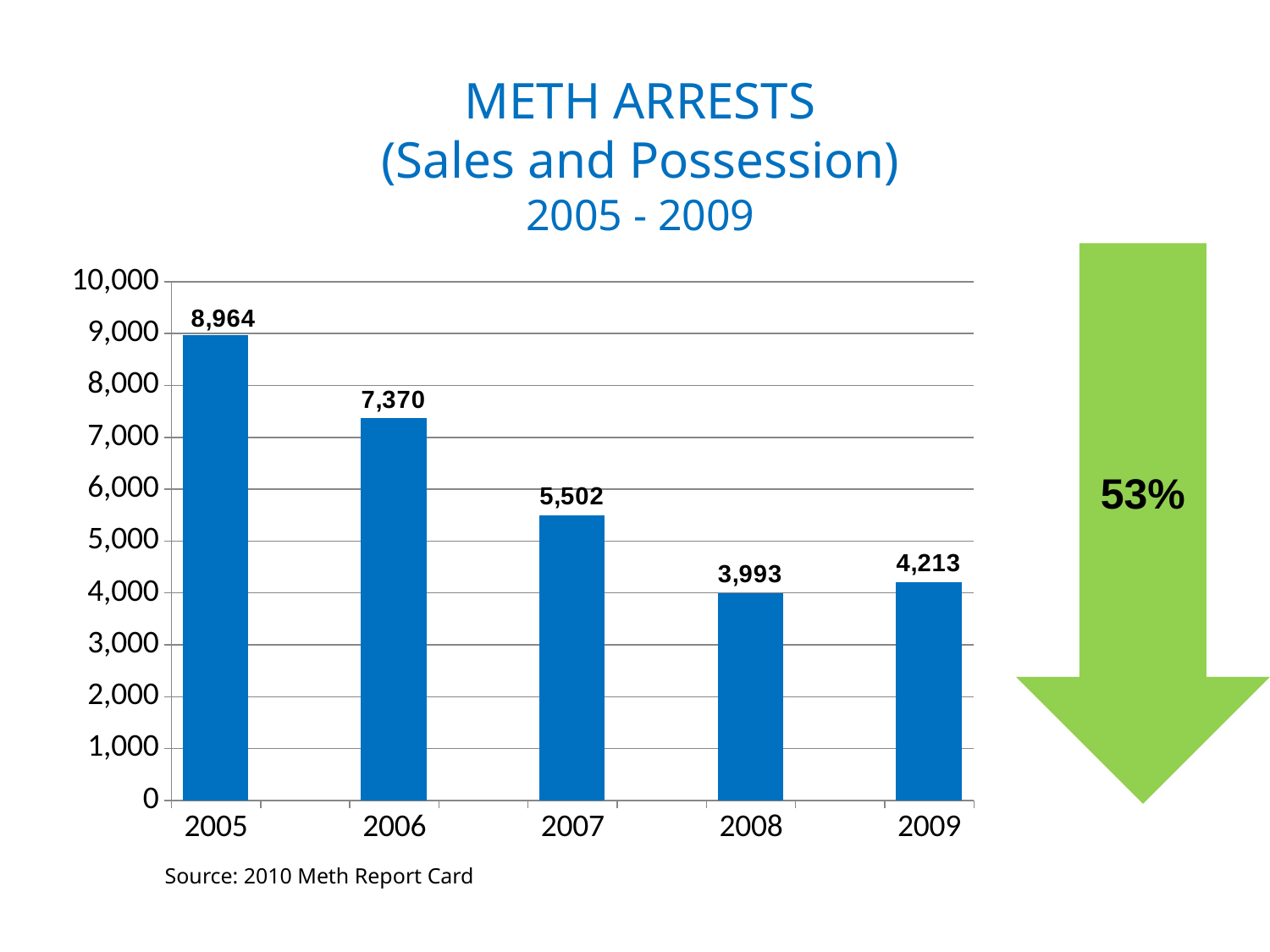
How many years are shown on the x axis? 5 What is the difference between the values for 2006 and 2007? 1,868 What kind of chart is shown on the slide? bar chart What is the value for 2009? 4,213 Which year has the highest number of meth arrests? 2005 What is the difference between the values for 2005 and 2009? 4,751 Do the values generally rise or fall from 2005 to 2009? fall Which is larger, the value for 2008 or the value for 2009? 2009 Which year has the lowest number of meth arrests? 2008 What is the value for 2008? 3,993 Is the value for 2007 greater or less than 6,000? less What is the value for 2005? 8,964